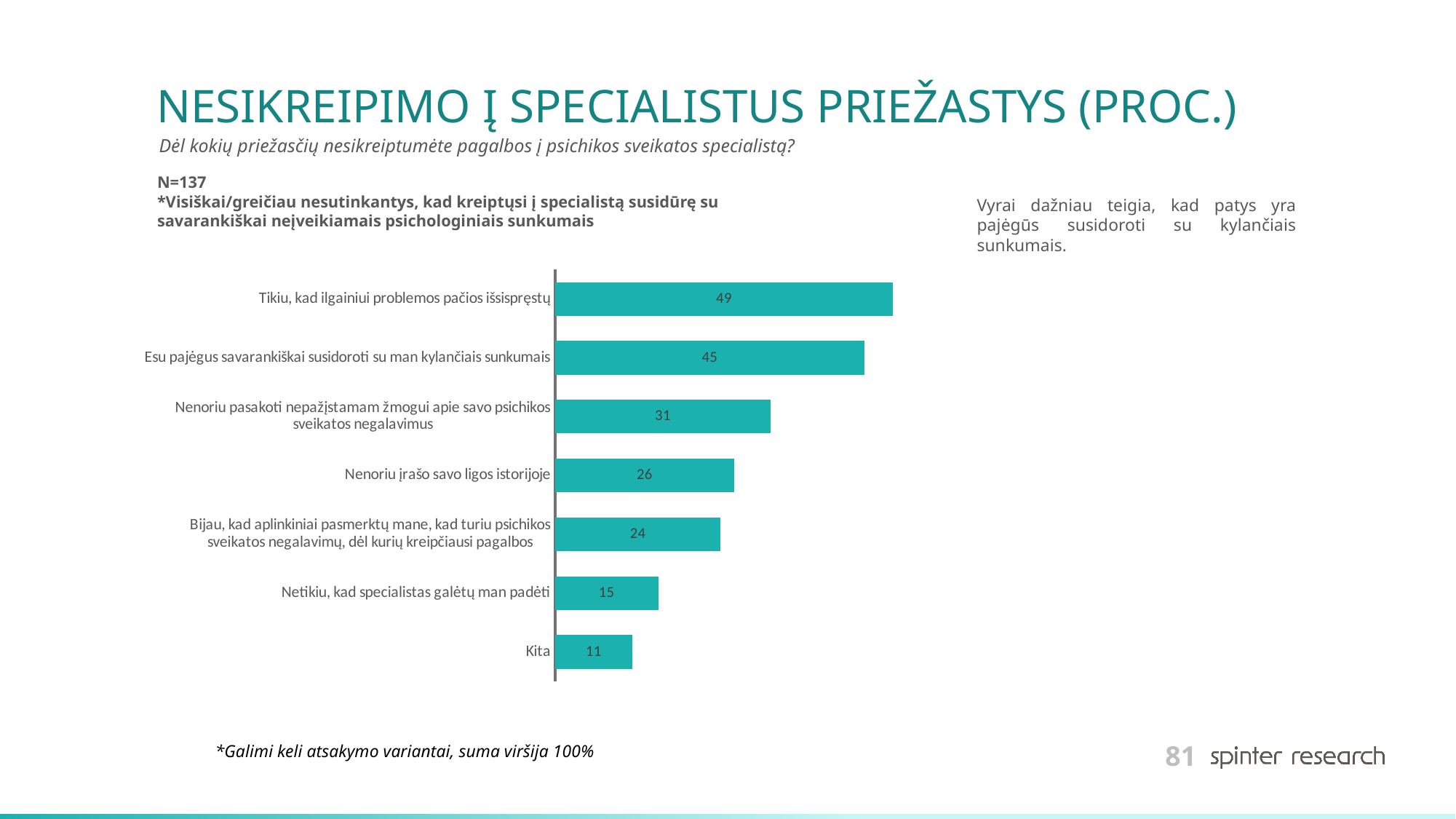
Which category has the highest value? Tikiu, kad ilgainiui problemos pačios išsispręstų What is the value for "Netikiu, kad specialistas galėtų man padėti"? 15 What is the value for "Tikiu, kad ilgainiui problemos pačios išsispręstų"? 49 What is the value for "Kita"? 11 What is the difference between the values for "Esu pajėgus savarankiškai susidoroti su man kylančiais sunkumais" and "Nenoriu pasakoti nepažįstamam žmogui apie savo psichikos sveikatos negalavimus"? 14 What kind of chart is shown on the slide? Bar chart How many categories are shown in the chart? 7 What is the difference between the highest and lowest values in the chart? 38 Which category has the lowest value? Kita What is the sample size (N) stated on the slide? N=137 Which is larger: the value for "Nenoriu įrašo savo ligos istorijoje" or the value for "Bijau, kad aplinkiniai pasmerktų mane, kad turiu psichikos sveikatos negalavimų, dėl kurių kreipčiausi pagalbos"? Nenoriu įrašo savo ligos istorijoje What is the value for "Nenoriu įrašo savo ligos istorijoje"? 26